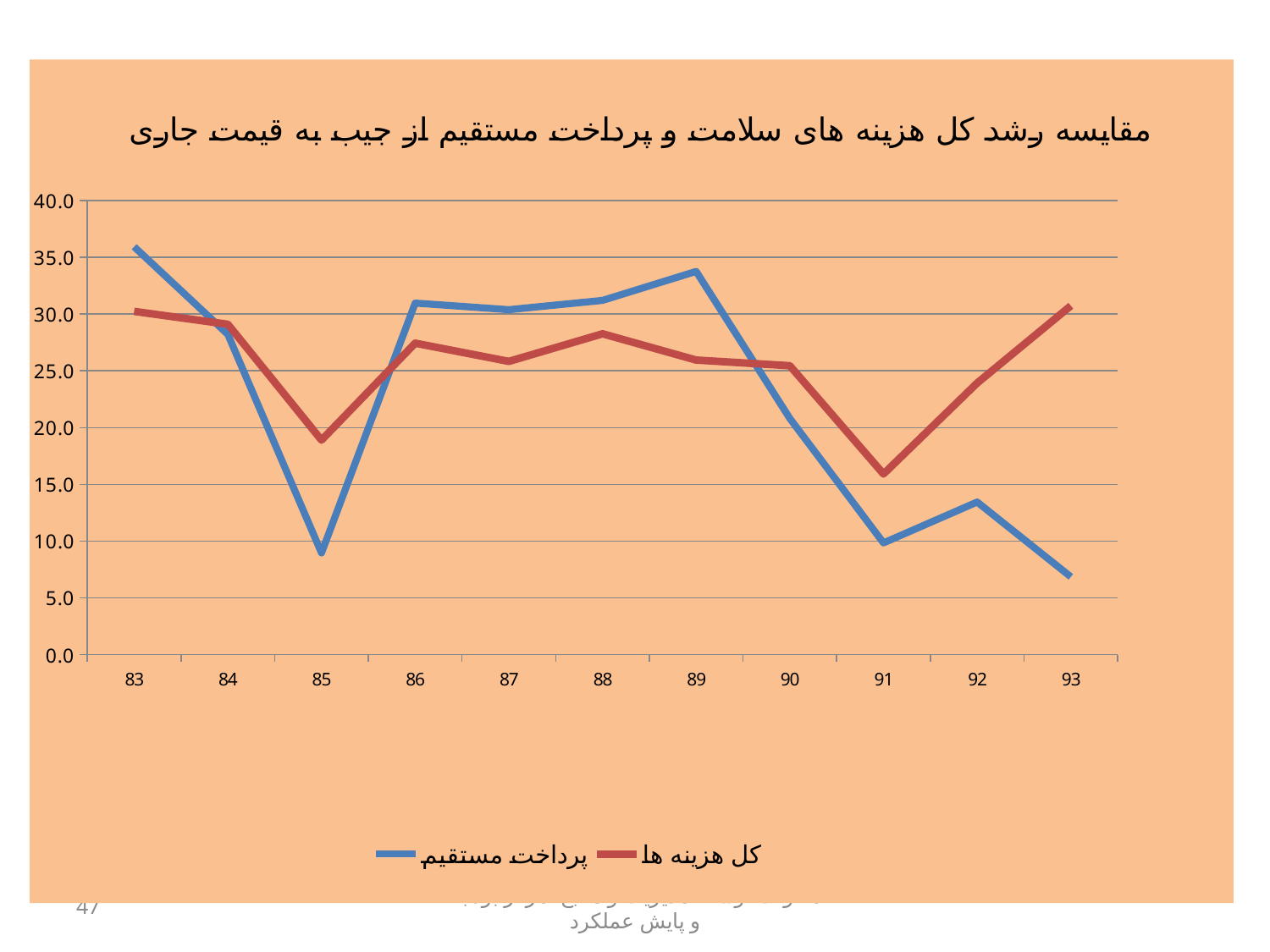
In which year does the کل هزینه ها series reach its lowest value? 91 How many years are plotted along the x axis? 11 Is the value for کل هزینه ها in 91 greater or less than 20.0? less In 89, which series has the higher value, پرداخت مستقیم or کل هزینه ها? پرداخت مستقیم In which year does the پرداخت مستقیم series reach its highest value? 83 Does the کل هزینه ها series rise or fall from 91 to 93? rise How many series does the legend list? 2 Is the value for پرداخت مستقیم in 85 greater or less than 15.0? less In 85, which series has the higher value, پرداخت مستقیم or کل هزینه ها? کل هزینه ها What kind of chart is shown on the slide? line chart Is the value for پرداخت مستقیم in 93 greater or less than 10.0? less